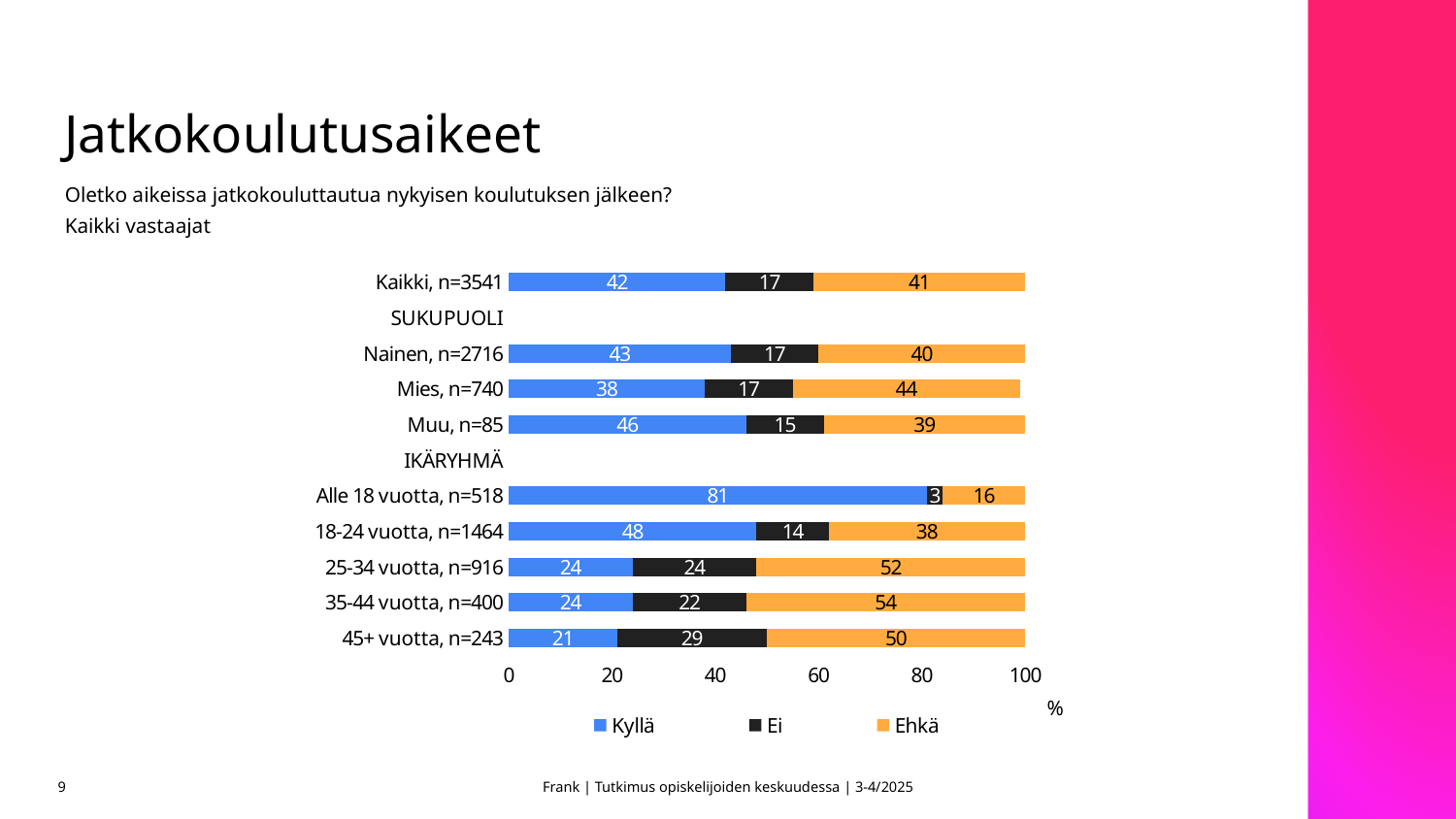
How many groups have bars plotted in the chart? 9 How many series does the legend list? 3 What is the Ehkä value for 35-44 vuotta, n=400? 54 Which is larger, the Ehkä value for Mies, n=740 or for Nainen, n=2716? Mies, n=740 What is the Kyllä value for Kaikki, n=3541? 42 Which group has the highest Kyllä value? Alle 18 vuotta, n=518 What is the total of the stacked bar for 25-34 vuotta, n=916? 100 What is the difference between the Kyllä values for Alle 18 vuotta, n=518 and 18-24 vuotta, n=1464? 33 What is the Ei value for Alle 18 vuotta, n=518? 3 Which group has the highest Ei value? 45+ vuotta, n=243 What kind of chart is shown on the slide? Stacked bar chart Which group has the lowest Kyllä value? 45+ vuotta, n=243